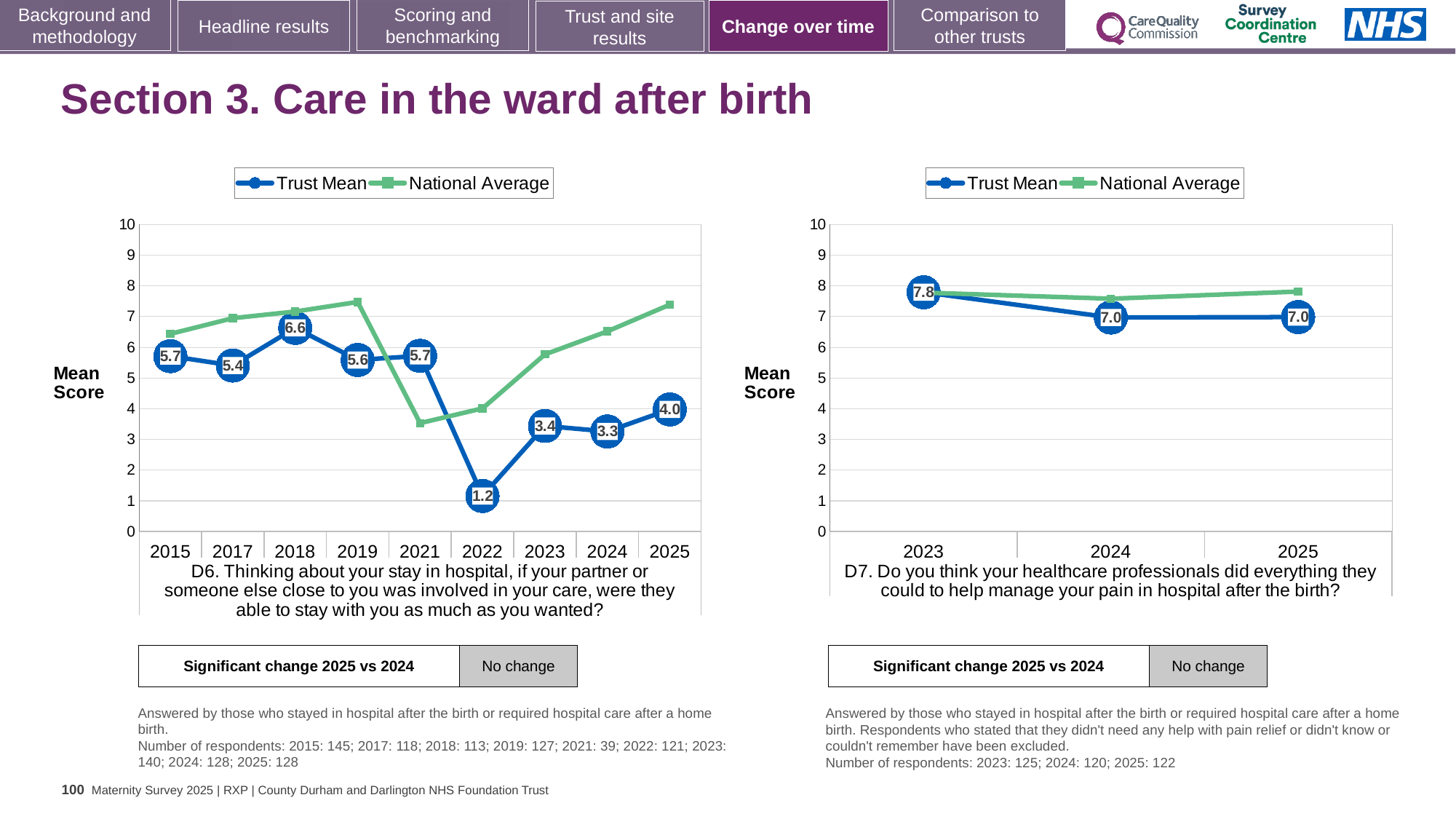
In the left chart (D6), what is the Trust Mean score for 2022? 1.2 In the left chart (D6), what is the difference between the Trust Mean scores for 2018 and 2022? 5.4 In the left chart (D6), which year has the highest Trust Mean score? 2018 In the left chart (D6), is the National Average value for 2021 greater or less than 4? less In the left chart (D6), how many years are plotted on the x axis? 9 In the left chart (D6), which is larger, the Trust Mean for 2015 or the Trust Mean for 2023? 2015 In the left chart (D6), what is the Trust Mean score for 2025? 4.0 What type of chart is the right chart (D7)? Line chart In the right chart (D7), what is the Trust Mean score for 2023? 7.8 In the right chart (D7), what is the difference between the Trust Mean scores for 2023 and 2025? 0.8 In the left chart (D6), which year has the lowest Trust Mean score? 2022 How many series does the legend of the right chart (D7) list? 2